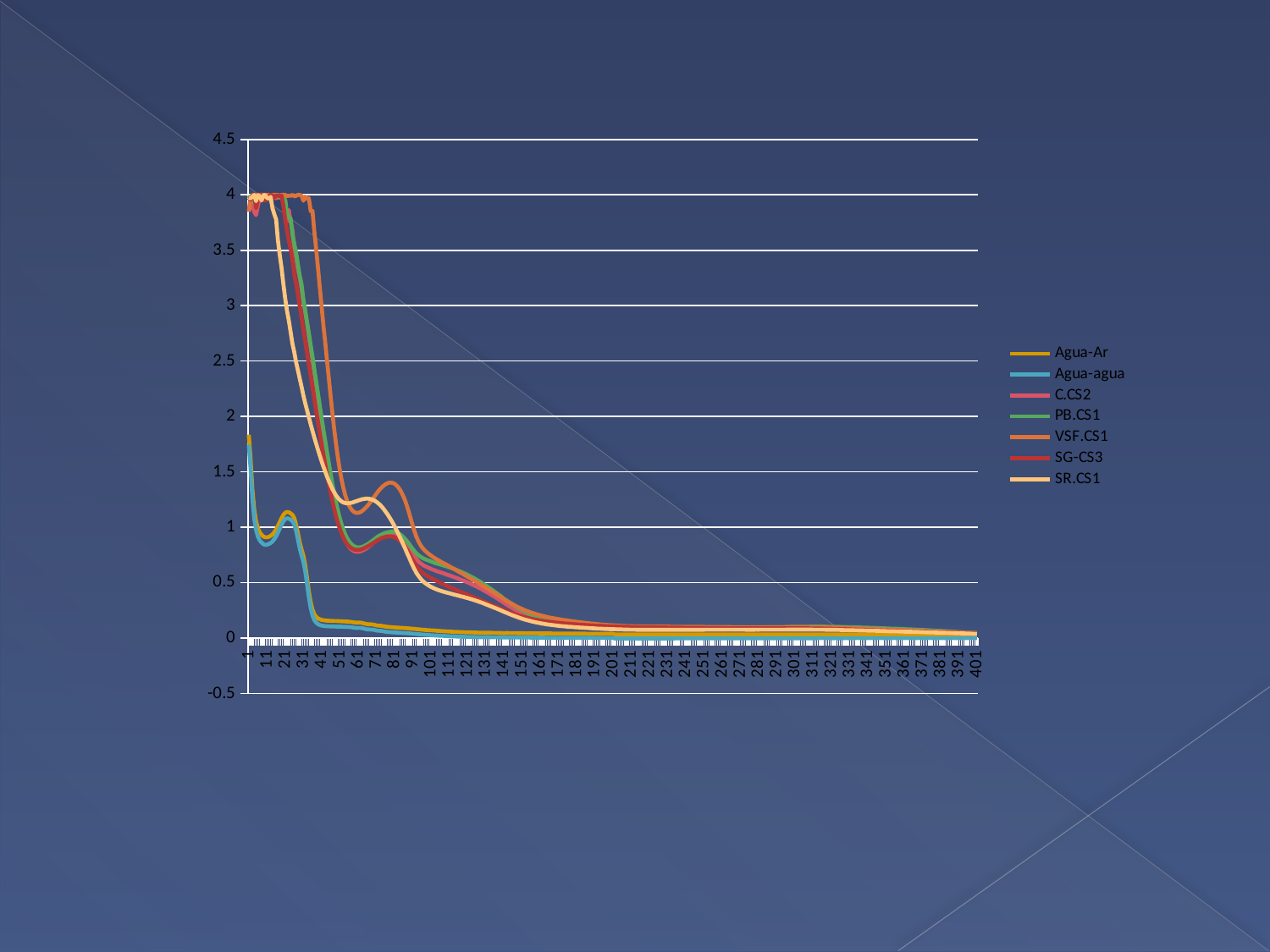
Is the value for VSF.CS1 at x = 11 greater or less than 3.5? greater Is the value for Agua-agua at x = 401 greater or less than 0.5? less Is the value for Agua-agua at x = 51 greater or less than 0.5? less What kind of chart is shown on the slide? line chart How many labelled tick marks are shown on the x axis? 41 Do the plotted values generally rise or fall as the x axis increases from 1 to 401? fall At x = 11, which series has the larger value, VSF.CS1 or Agua-agua? VSF.CS1 How many series does the legend list? 7 Which series is listed first in the legend? Agua-Ar What is the highest value labelled on the y axis? 4.5